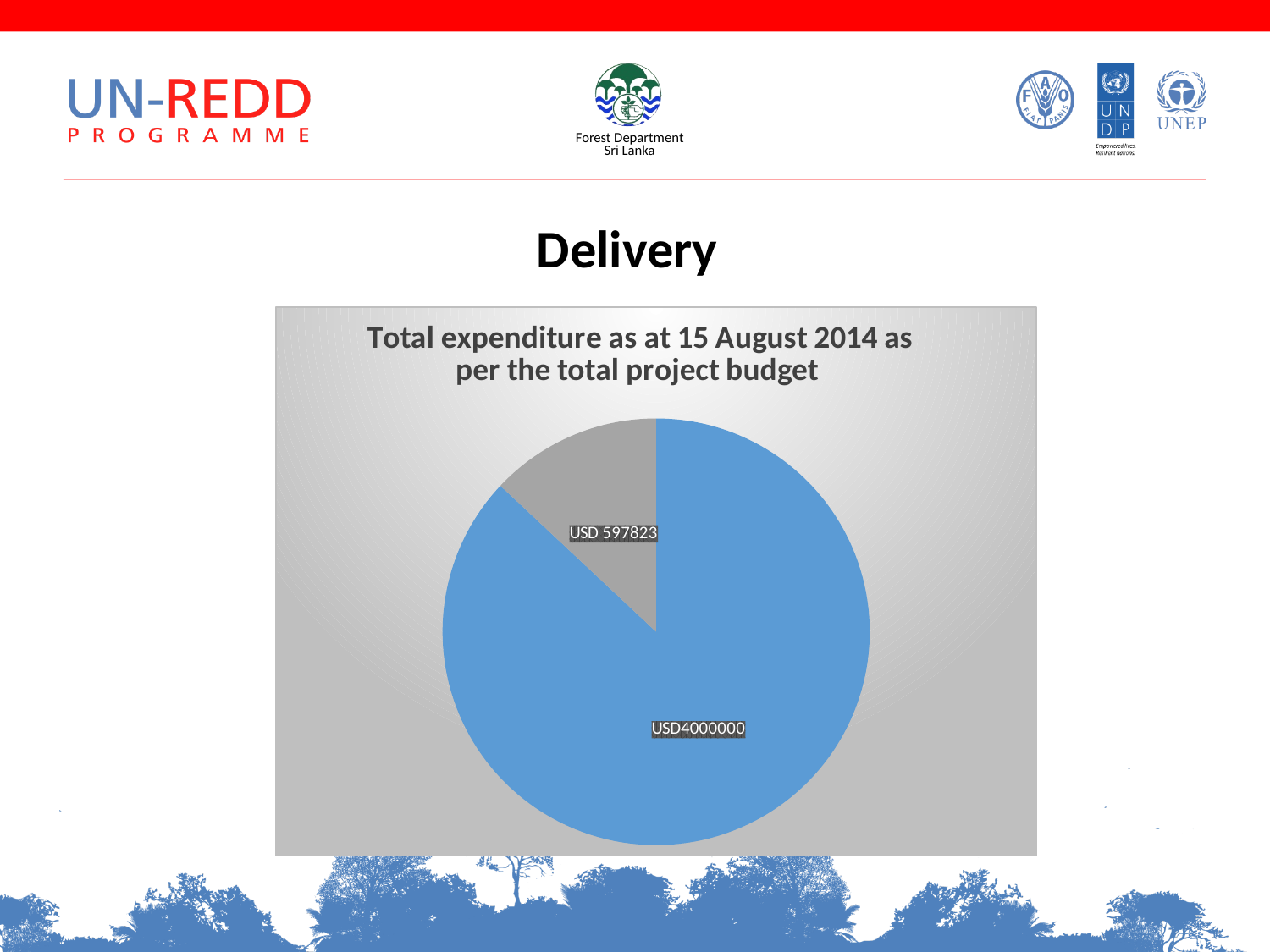
What is the total of the two values shown on the pie chart? USD 4597823 How many slices does the pie chart have? 2 Which slice of the pie chart is the smallest? the grey slice (USD 597823) What kind of chart is shown on the slide? pie chart Which is larger, the blue slice or the grey slice? the blue slice What value is labelled on the grey slice of the pie chart? USD 597823 What colour is the slice labelled USD4000000? blue What is the title of the chart? Total expenditure as at 15 August 2014 as per the total project budget What is the difference between the value of the blue slice and the value of the grey slice? USD 3402177 Which slice of the pie chart is the largest? the blue slice (USD4000000) What value is labelled on the blue slice of the pie chart? USD4000000